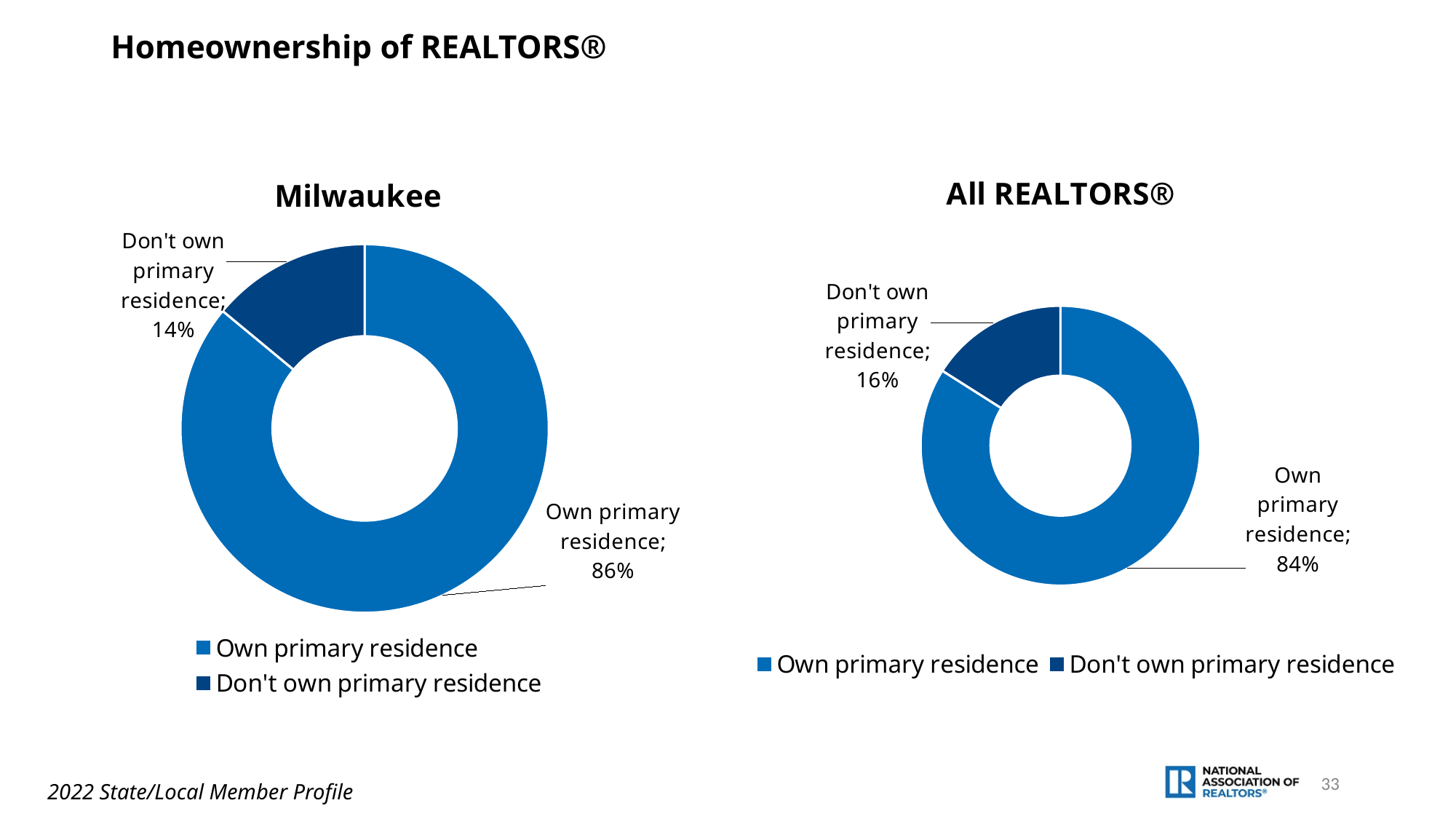
In the All REALTORS® chart, what percentage own their primary residence? 84% What is the title of the slide? Homeownership of REALTORS® How many entries does the legend of the All REALTORS® chart list? 2 In the Milwaukee chart, what percentage of REALTORS® own their primary residence? 86% In the Milwaukee chart, what is the difference in percentage points between those who own and those who don't own their primary residence? 72 In the All REALTORS® chart, what percentage don't own their primary residence? 16% How many categories does the Milwaukee chart show? 2 In the Milwaukee chart, which category has the largest share? Own primary residence What kind of chart is the Milwaukee chart? Doughnut (pie) chart In the Milwaukee chart, what percentage of REALTORS® don't own their primary residence? 14% In the All REALTORS® chart, which category has the smallest share? Don't own primary residence Is the share of REALTORS® who own their primary residence larger in the Milwaukee chart or the All REALTORS® chart? Milwaukee